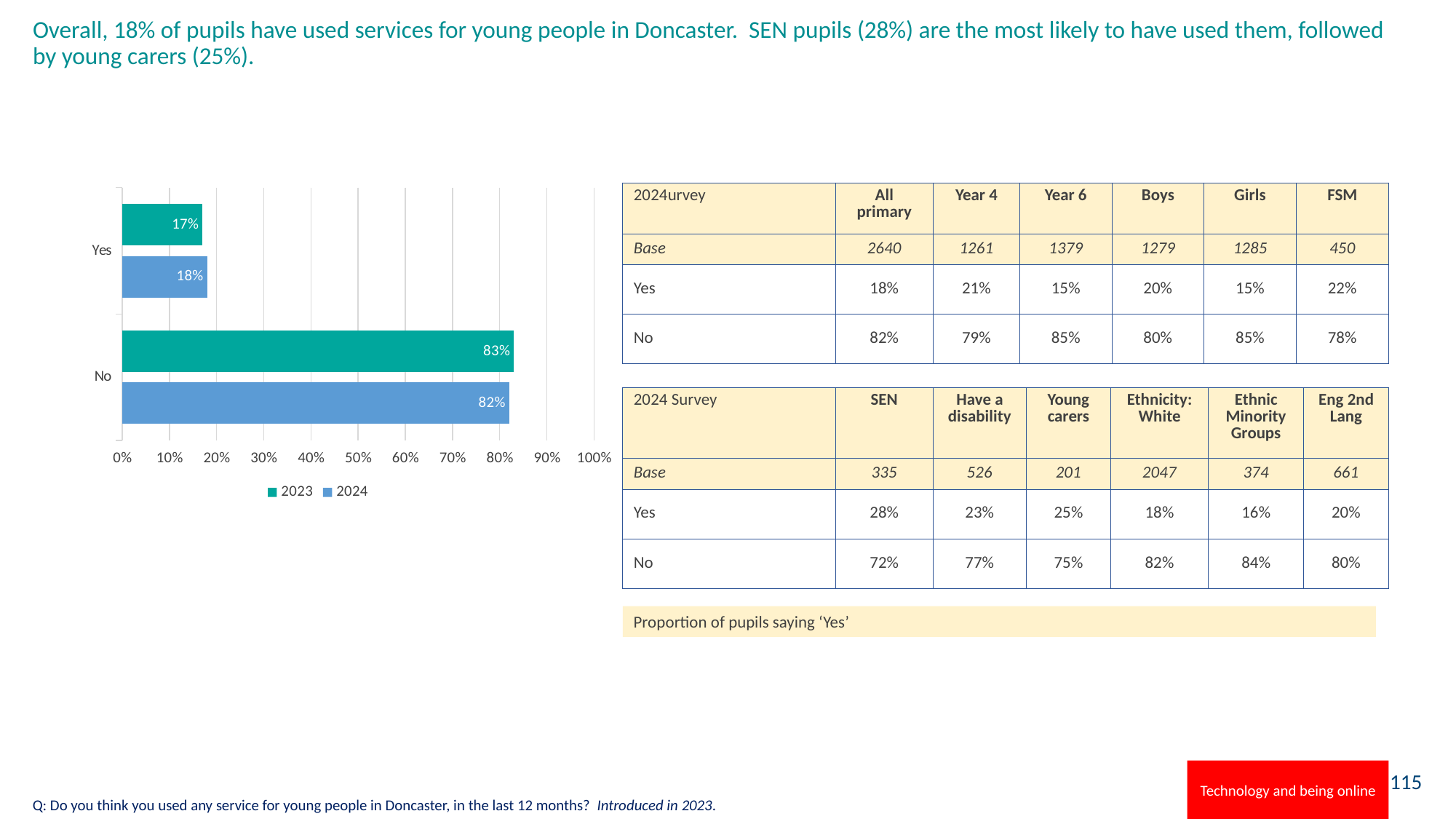
Which category has the lowest value in the 2023 series? Yes How many categories are shown on the chart? 2 What is the difference between the 2023 and 2024 values for 'No'? 1% What is the value for 'Yes' in the 2024 series? 18% What is the value for 'Yes' in the 2023 series? 17% What is the value for 'No' in the 2023 series? 83% What kind of chart is shown on the slide? Bar chart How many series does the legend list? 2 What is the value for 'No' in the 2024 series? 82% Which category has the highest value in the 2024 series? No Which is larger for 'Yes': the 2023 value or the 2024 value? 2024 What are the two series named in the chart legend? 2023 and 2024